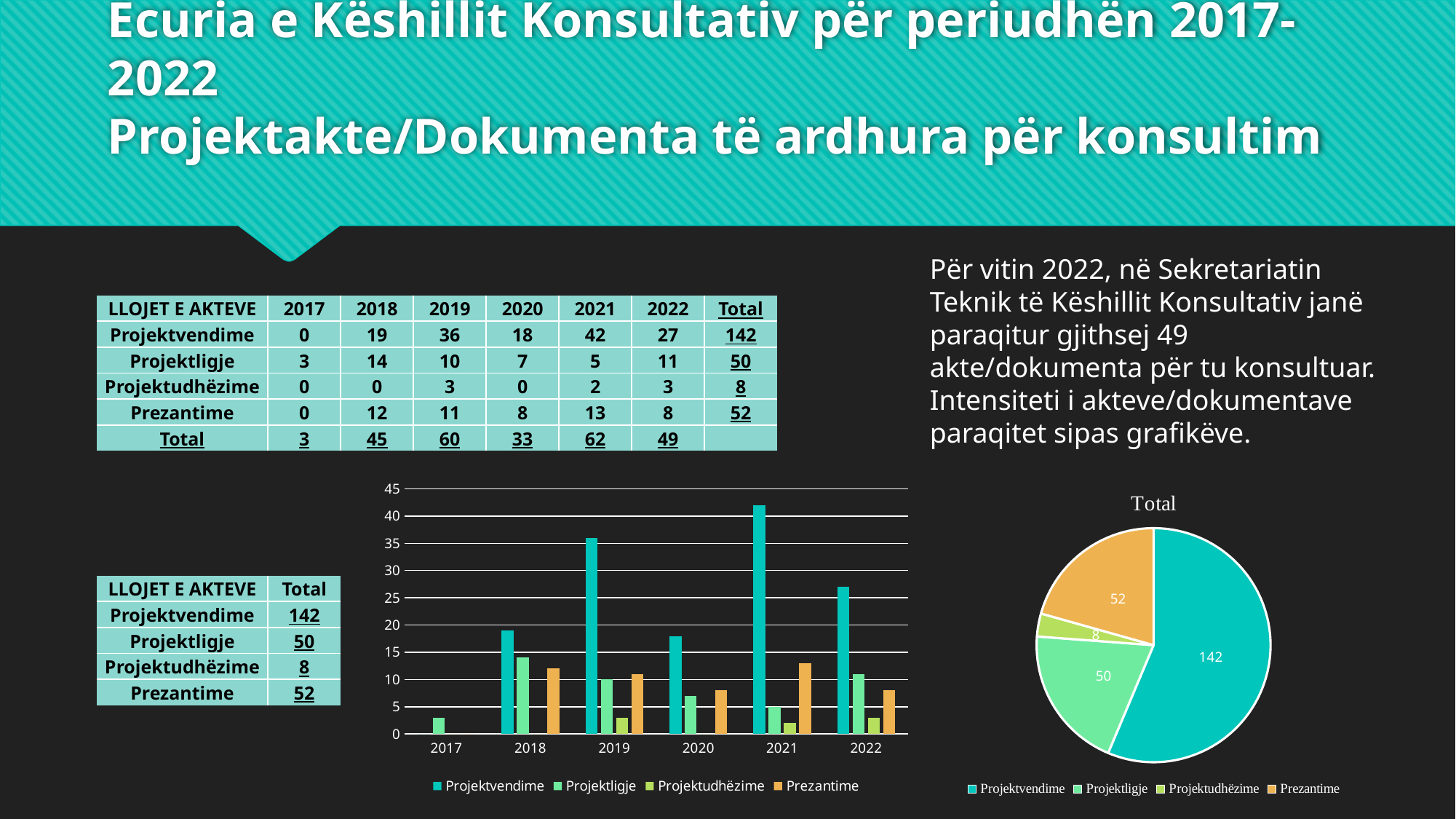
What is the title of the pie chart on the right of the slide? Total In the bar chart, which year has the tallest Projektvendime bar? 2021 In the bar chart, is the Projektvendime value for 2021 greater or less than 40? greater In the bar chart, which is larger for 2020: Projektvendime or Prezantime? Projektvendime In the pie chart titled Total, what is the value for Projektvendime? 142 In the bar chart, what is the Projektligje value for 2019? 10 How many series does the legend of the bar chart list? 4 In the bar chart, is the Projektvendime value for 2019 greater or less than 30? greater In the pie chart titled Total, which category has the smallest slice? Projektudhëzime How many years are shown on the x axis of the bar chart? 6 In the pie chart titled Total, what is the difference between the Prezantime value and the Projektligje value? 2 What kind of chart is the chart in the middle of the slide, with years on the x axis? bar chart